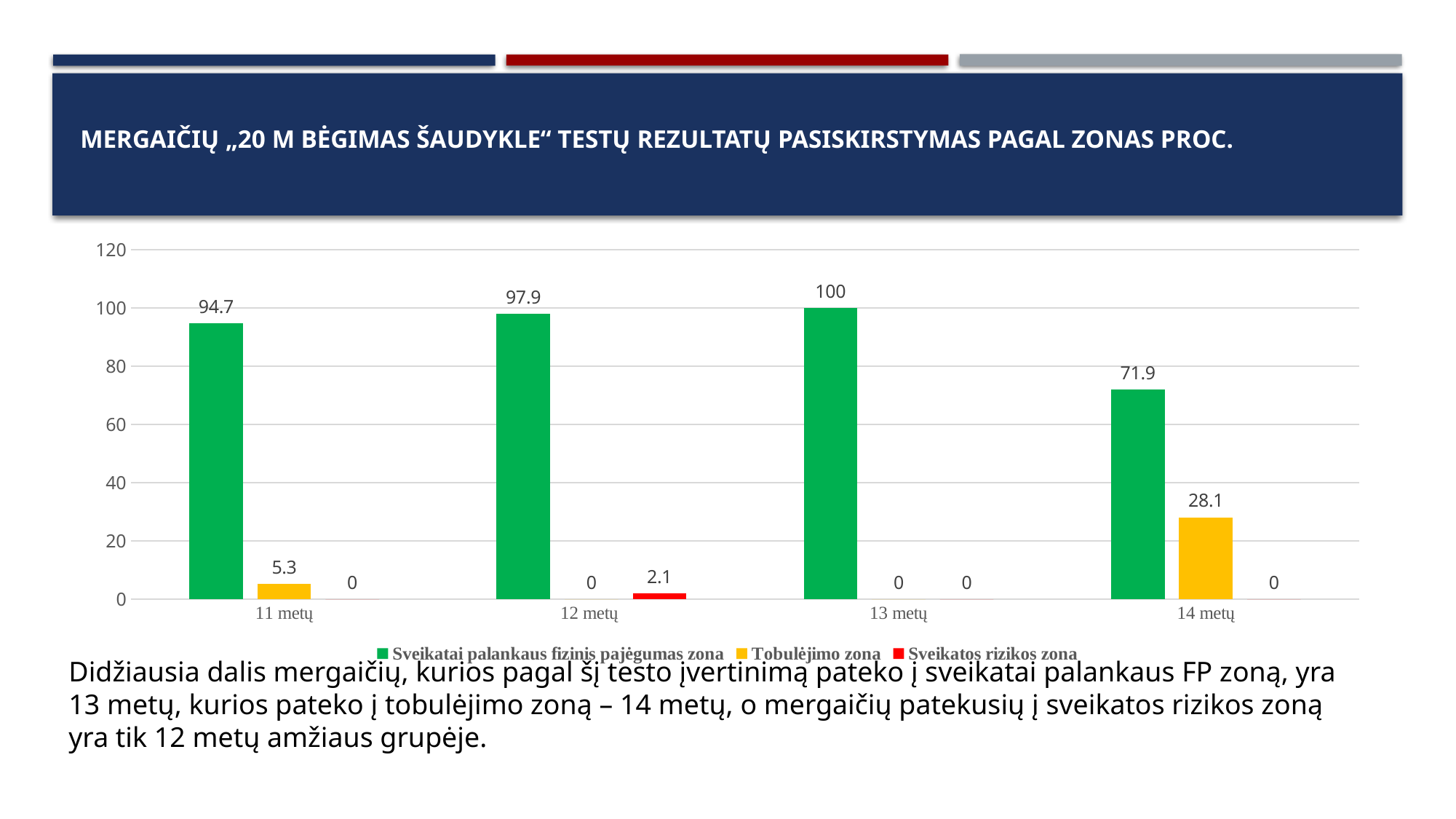
How many series does the legend list? 3 Which age group has the highest value for "Sveikatai palankaus fizinis pajėgumas zona"? 13 metų What is the value for "Tobulėjimo zona" for 14 metų? 28.1 What is the value for "Sveikatai palankaus fizinis pajėgumas zona" for 13 metų? 100 What kind of chart is shown on the slide? bar chart What is the value for "Sveikatos rizikos zona" for 12 metų? 2.1 Is the value for "Sveikatai palankaus fizinis pajėgumas zona" for 14 metų greater or less than 80? less Which age group has the lowest value for "Sveikatai palankaus fizinis pajėgumas zona"? 14 metų What is the value for "Tobulėjimo zona" for 11 metų? 5.3 How many age groups are shown on the x axis? 4 Which is larger: the "Tobulėjimo zona" value for 11 metų or for 14 metų? 14 metų What is the difference between the "Sveikatai palankaus fizinis pajėgumas zona" values for 12 metų and 14 metų? 26